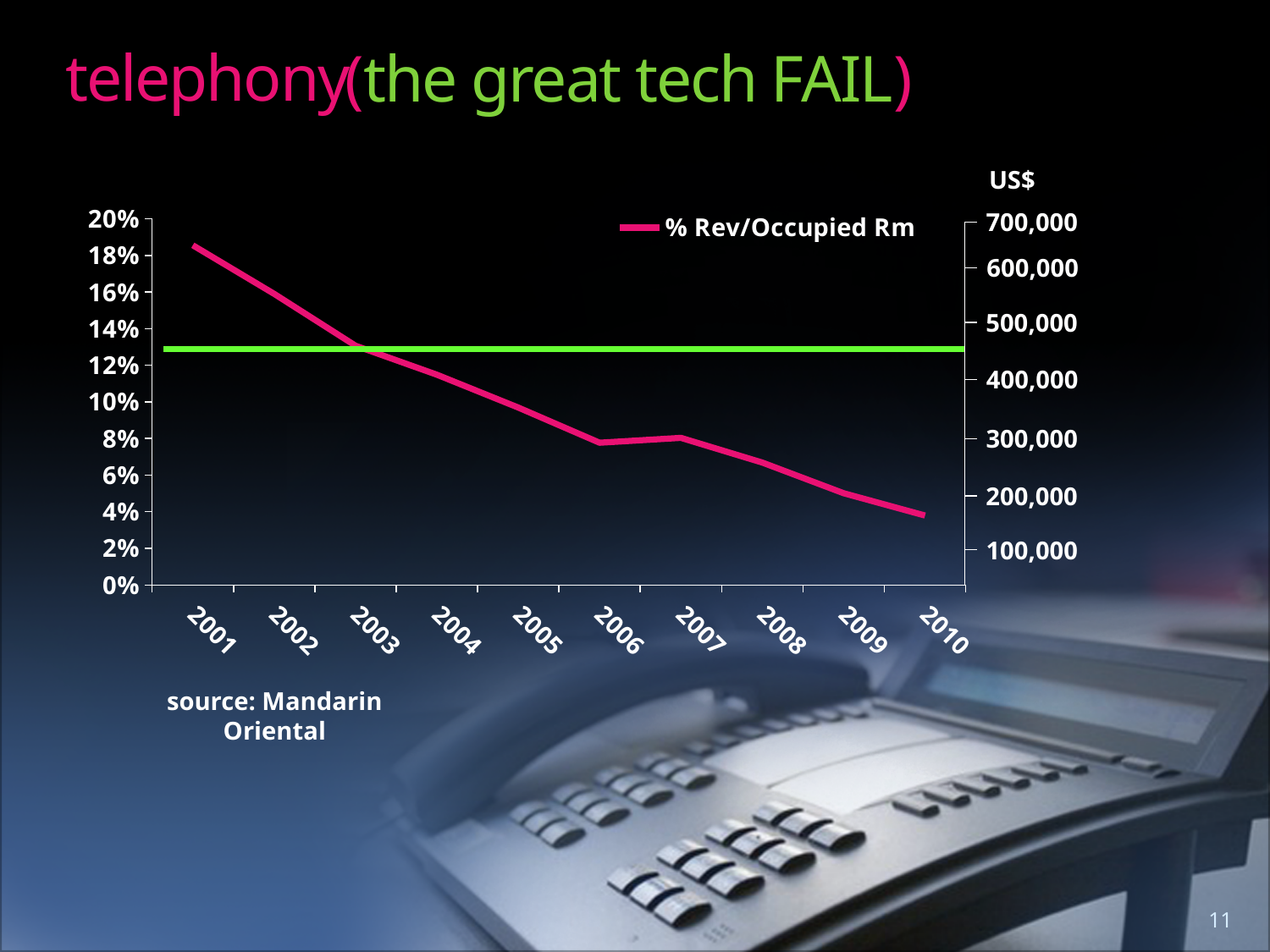
Is the % Rev/Occupied Rm value for 2010 greater or less than 6%? less What is the name of the series listed in the chart's legend? % Rev/Occupied Rm Does the % Rev/Occupied Rm line rise or fall from 2001 to 2010? fall Which year has the larger % Rev/Occupied Rm value, 2003 or 2008? 2003 What kind of chart is shown on the slide? line chart Is the % Rev/Occupied Rm value for 2001 greater or less than 16%? greater How many series does the chart's legend list? 1 Is the % Rev/Occupied Rm value for 2006 greater or less than 10%? less What unit label appears above the right-hand axis of the chart? US$ In which year is % Rev/Occupied Rm highest? 2001 How many years are shown along the x axis of the chart? 10 In which year is % Rev/Occupied Rm lowest? 2010